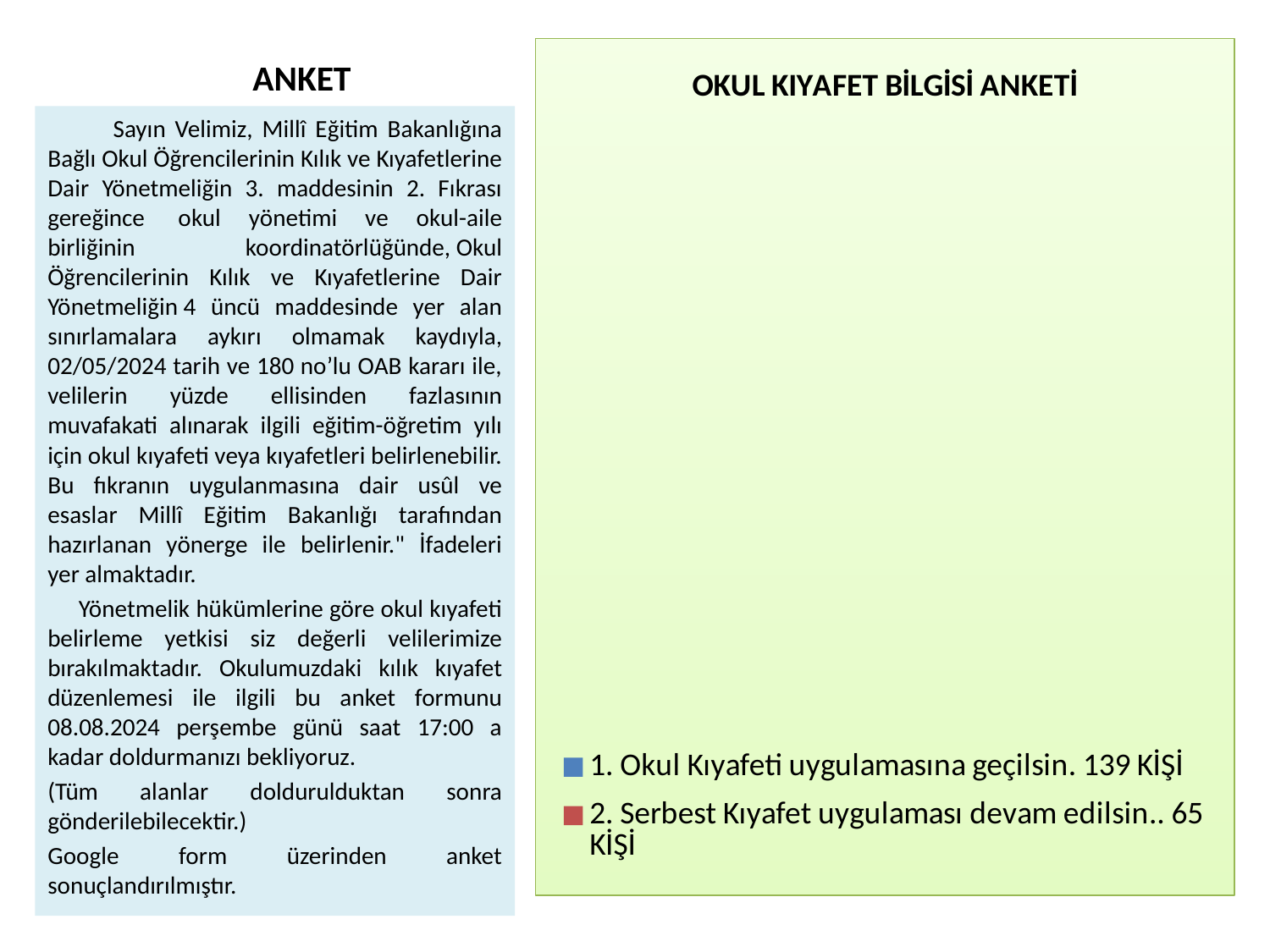
What is the title of the chart on the right side of the slide? OKUL KIYAFET BİLGİSİ ANKETİ Is the number of people for option 1 larger or smaller than for option 2 in the chart legend? larger According to the chart legend, how many people chose '1. Okul Kıyafeti uygulamasına geçilsin.'? 139 KİŞİ Which option in the chart legend has the higher number of people? 1. Okul Kıyafeti uygulamasına geçilsin. What is the total number of people across the two options listed in the chart legend? 204 What colour is the legend marker for '2. Serbest Kıyafet uygulaması devam edilsin..'? red How many entries does the chart legend list? 2 What is the difference in number of people between option 1 and option 2 in the chart legend? 74 Which option in the chart legend has the lower number of people? 2. Serbest Kıyafet uygulaması devam edilsin.. According to the chart legend, how many people chose '2. Serbest Kıyafet uygulaması devam edilsin..'? 65 KİŞİ